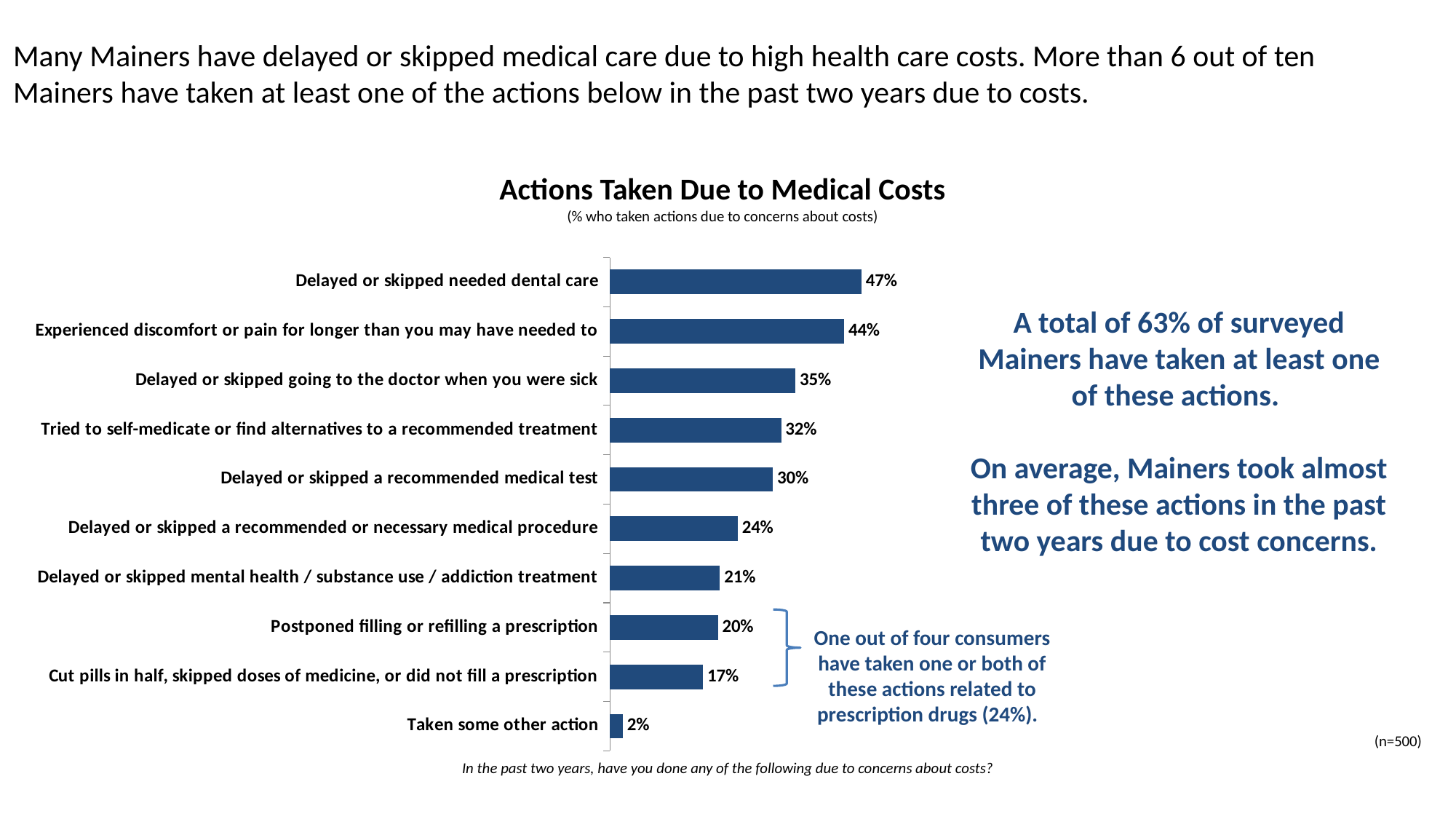
What type of chart is shown on the slide? Bar chart What is the value for 'Delayed or skipped a recommended medical test'? 30% Which action has the lowest percentage in the chart? Taken some other action Which is larger: the value for 'Tried to self-medicate or find alternatives to a recommended treatment' or the value for 'Delayed or skipped a recommended or necessary medical procedure'? Tried to self-medicate or find alternatives to a recommended treatment Which action has the highest percentage in the chart? Delayed or skipped needed dental care What is the difference between the percentage who postponed filling or refilling a prescription and the percentage who cut pills in half, skipped doses, or did not fill a prescription? 3% What percentage of respondents delayed or skipped needed dental care? 47% How many actions (categories) are shown in the chart? 10 What is the difference between the percentage who delayed or skipped needed dental care and the percentage who delayed or skipped going to the doctor when sick? 12% What percentage of respondents postponed filling or refilling a prescription? 20% What is the title of the chart? Actions Taken Due to Medical Costs What is the sample size (n) noted on the slide? n=500